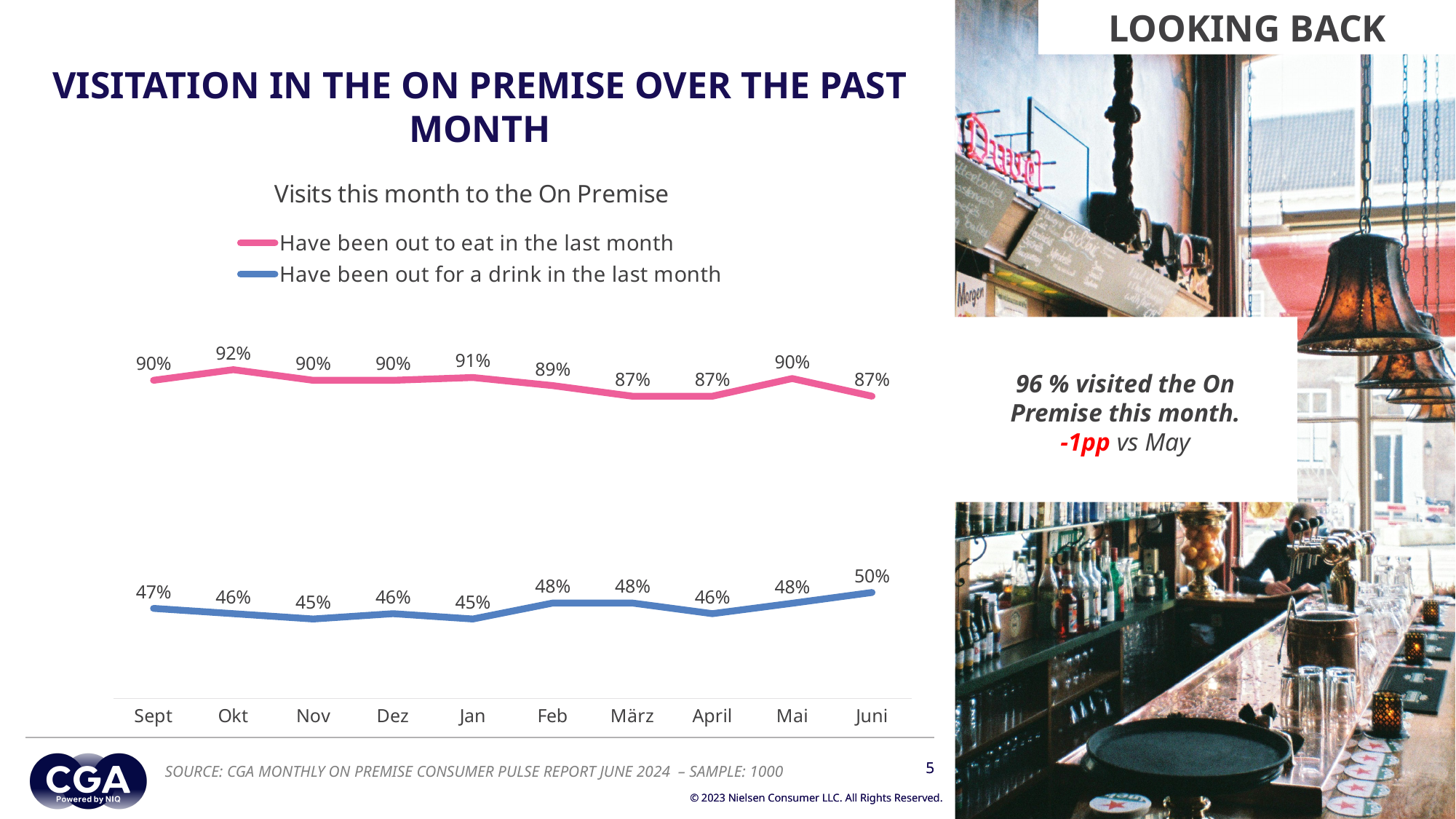
In which month is 'Have been out for a drink in the last month' highest? Juni What is the difference between the two series in Sept? 43 percentage points What kind of chart is shown? Line chart Which is larger in Mai: 'Have been out to eat in the last month' or 'Have been out for a drink in the last month'? Have been out to eat in the last month What is the difference between 'Have been out for a drink in the last month' in Juni and in Nov? 5 percentage points What is the value for 'Have been out to eat in the last month' in Okt? 92% What is the value for 'Have been out for a drink in the last month' in Juni? 50% What is the title of the chart? Visits this month to the On Premise How many months are shown on the x axis? 10 What is the value for 'Have been out to eat in the last month' in Feb? 89% How many series does the legend list? 2 In which month is 'Have been out to eat in the last month' highest? Okt